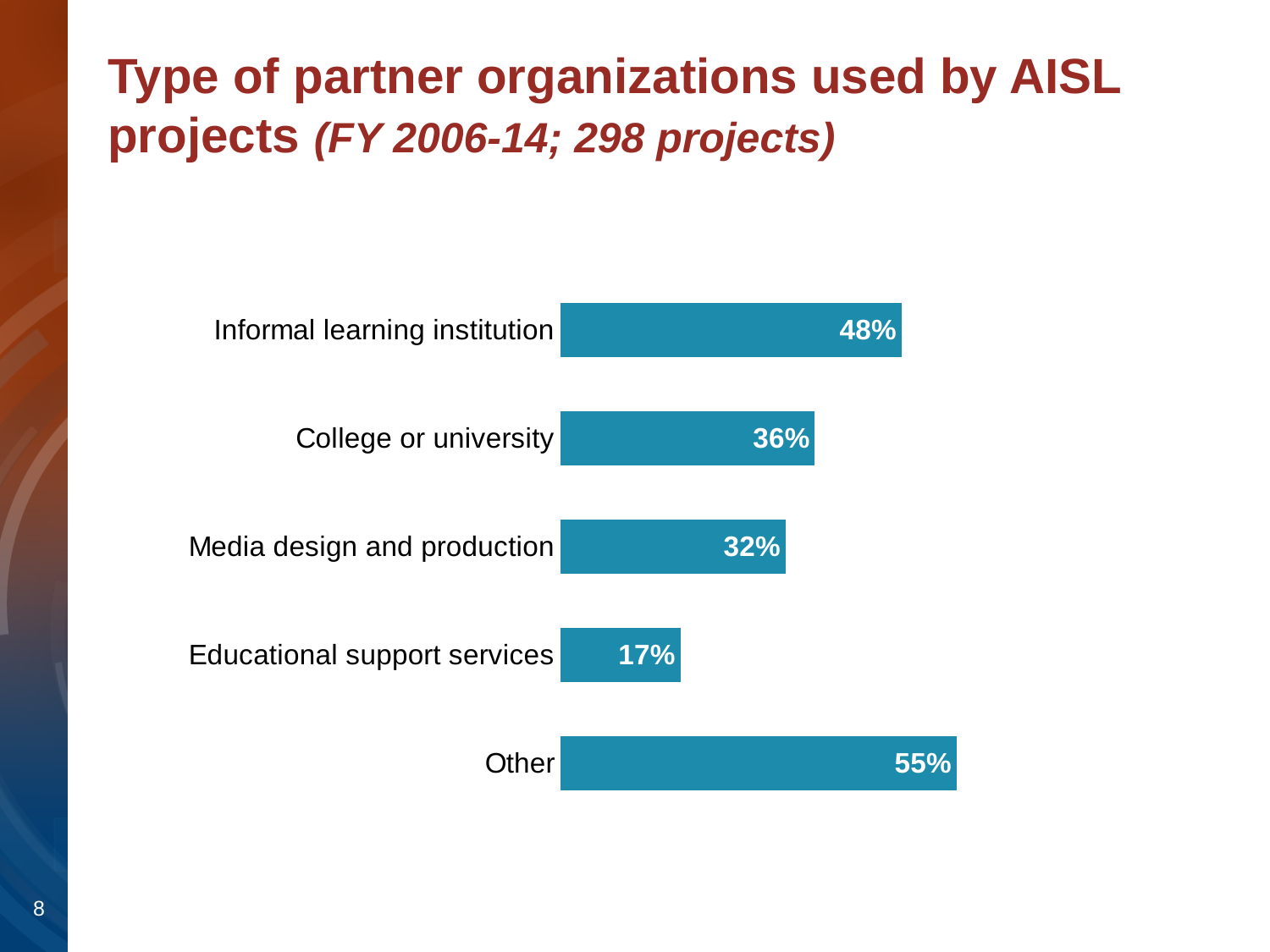
How many categories of partner organizations are shown in the chart? 5 What type of chart is shown on the slide? Bar chart Which is larger, the value for College or university or the value for Media design and production? College or university What is the value for Educational support services? 17% What percentage of AISL projects used an informal learning institution as a partner organization? 48% Which category has the highest percentage? Other What is the value shown for College or university? 36% What percentage is shown for the Other category? 55% What is the difference in percentage points between Other and Educational support services? 38 What is the difference in percentage points between Informal learning institution and College or university? 12 Which category has the lowest percentage? Educational support services What percentage is shown for Media design and production? 32%